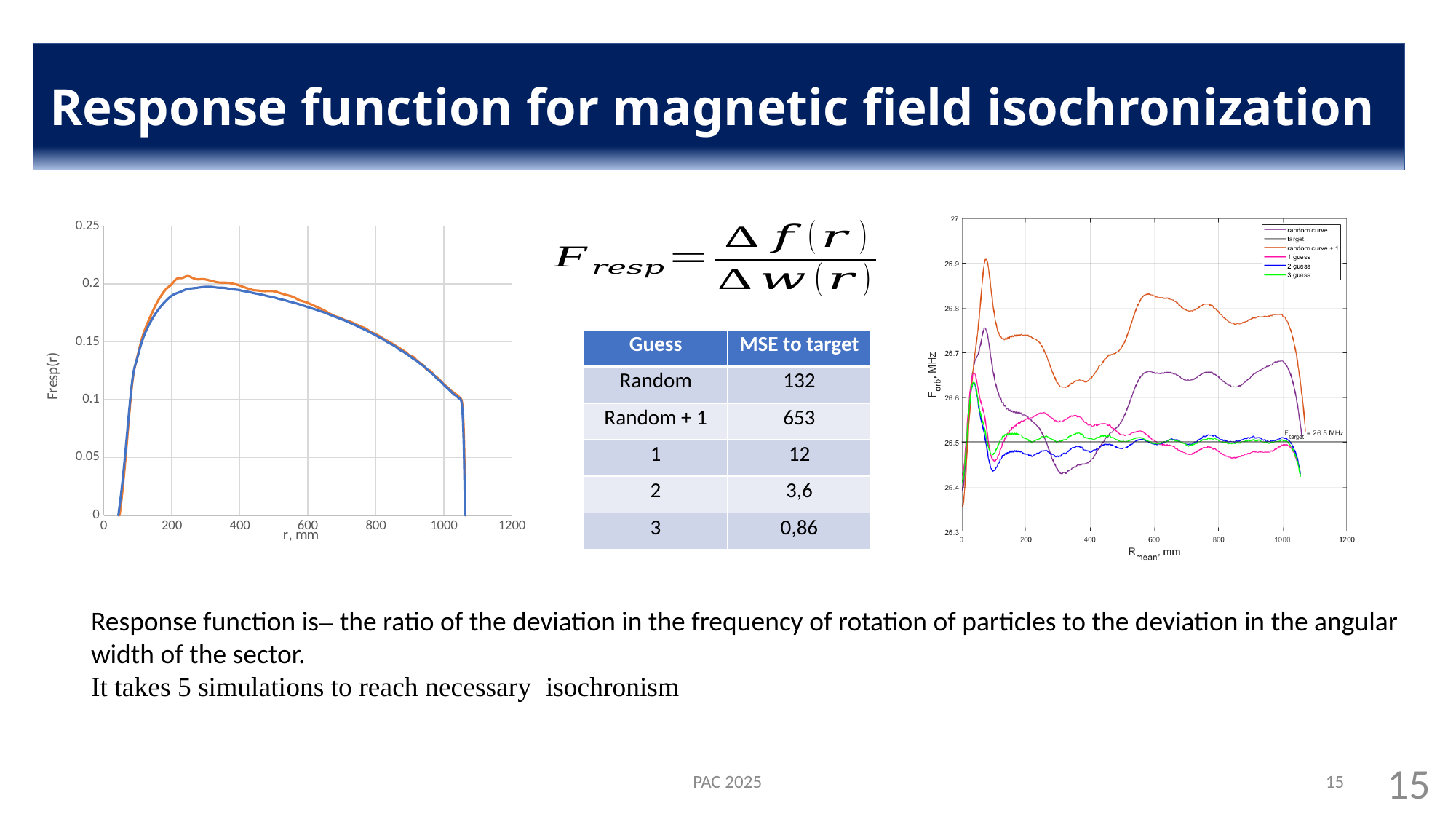
In the left chart, is the value of the orange line at r = 600 mm greater or less than 0.15? greater In the left chart, is the value of the blue line at r = 1000 mm greater or less than 0.1? greater What kind of chart is the left chart with Fresp(r) on the vertical axis? line chart In the right chart, which series has the highest values around R_mean = 600 mm? random curve + 1 In the right chart, is the value of the random curve + 1 series at R_mean = 600 mm greater or less than 26.7? greater What kind of chart is the right chart with F_orb, MHz on the vertical axis? line chart In the left chart, what is the highest tick value shown on the vertical axis? 0.25 In the left chart, what is the label of the horizontal axis? r, mm In the right chart, what target frequency is marked by the horizontal line annotation? 26.5 MHz In the right chart, how many series does the legend list? 6 In the left chart, how many lines are plotted? 2 In the left chart, do the values rise or fall as r increases from 400 mm to 1000 mm? fall